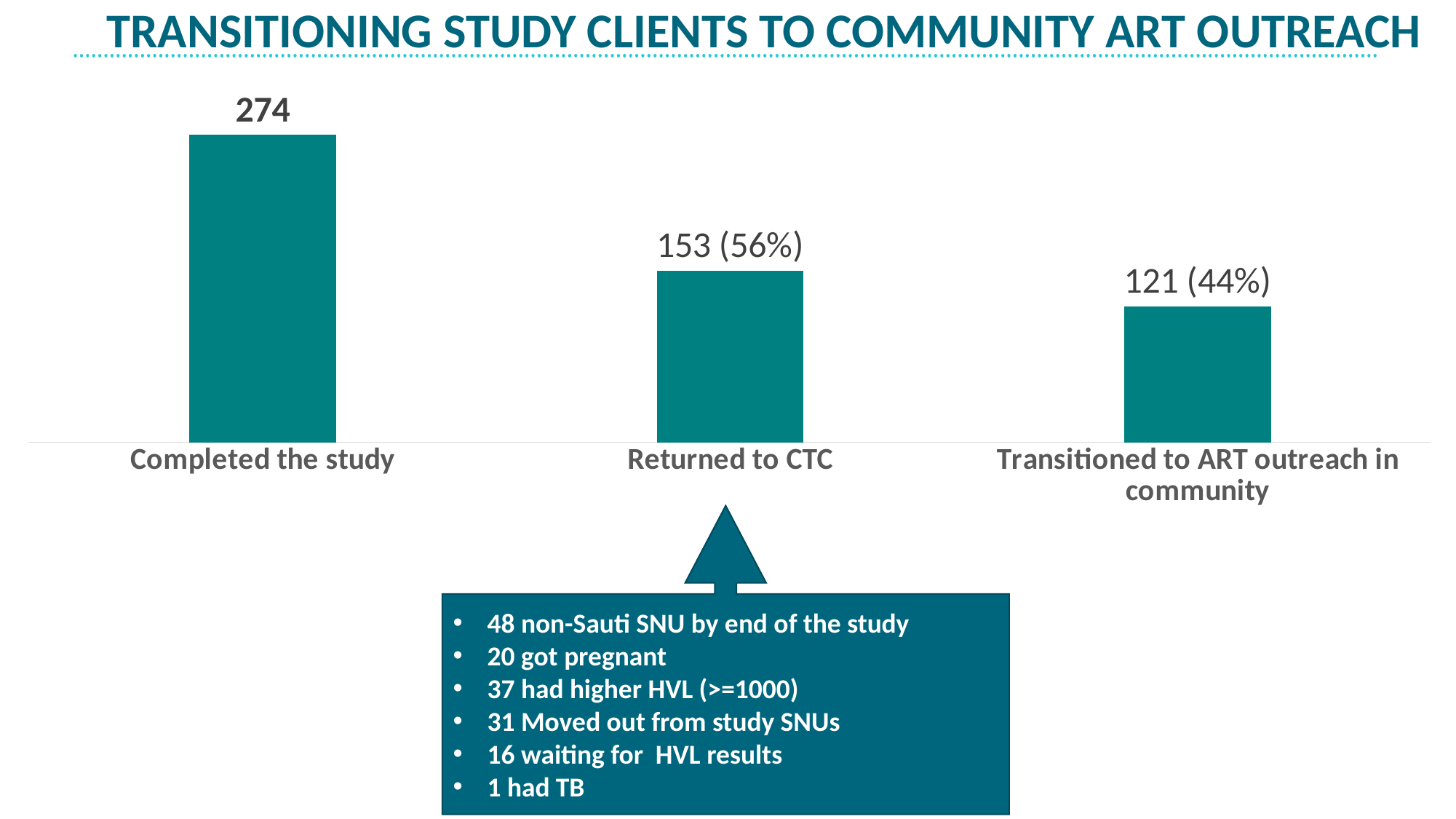
Which category has the highest value? Completed the study What kind of chart is shown on the slide? Bar chart What label is printed above the Returned to CTC bar? 153 (56%) Which category has the lowest value? Transitioned to ART outreach in community Do the bar values rise or fall from left to right? Fall What label is printed above the Transitioned to ART outreach in community bar? 121 (44%) Which is larger, the value for Returned to CTC or the value for Transitioned to ART outreach in community? Returned to CTC What is the title of the slide? Transitioning Study Clients to Community ART Outreach What is the difference between the Completed the study value and the Returned to CTC value? 121 What is the difference between the Returned to CTC value and the Transitioned to ART outreach in community value? 32 How many bars are shown in the chart? 3 What value is shown for Completed the study? 274